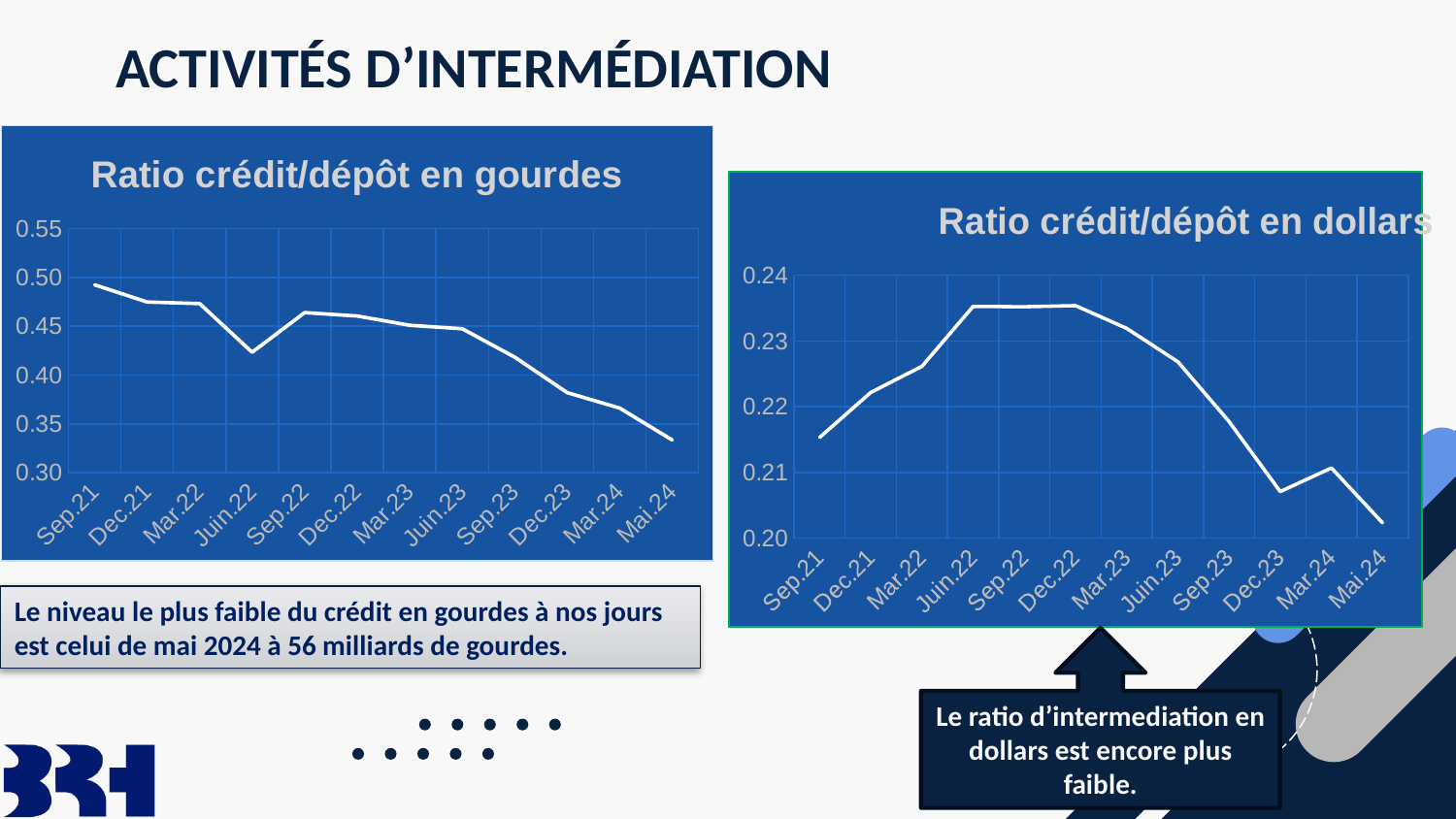
On the 'Ratio crédit/dépôt en gourdes' chart, is the value for Dec.23 greater or less than 0.40? less How many data points are plotted on the 'Ratio crédit/dépôt en dollars' chart? 12 On the 'Ratio crédit/dépôt en dollars' chart, which period has the lowest value? Mai.24 On the 'Ratio crédit/dépôt en dollars' chart, is the value for Mai.24 greater or less than 0.21? less On the 'Ratio crédit/dépôt en gourdes' chart, is the value for Mai.24 greater or less than 0.35? less On the 'Ratio crédit/dépôt en gourdes' chart, which period has the lowest value? Mai.24 On the 'Ratio crédit/dépôt en gourdes' chart, which period has the highest value? Sep.21 On the 'Ratio crédit/dépôt en dollars' chart, which is larger, the value for Sep.21 or the value for Mai.24? Sep.21 What type of chart is the 'Ratio crédit/dépôt en gourdes' chart? line chart On the 'Ratio crédit/dépôt en dollars' chart, do the values rise or fall from Dec.22 to Mai.24? fall